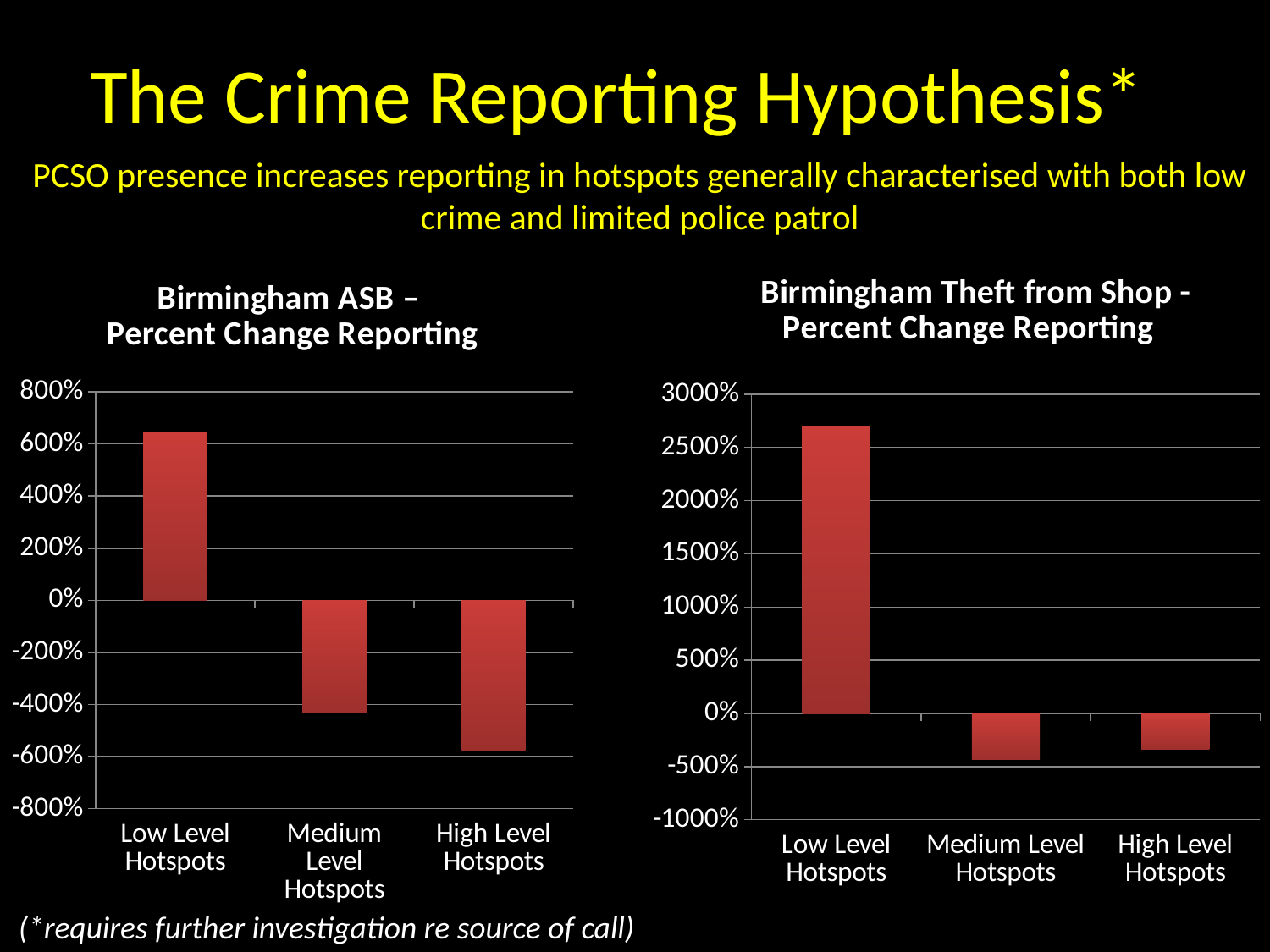
In the Birmingham ASB – Percent Change Reporting chart, is the value for Low Level Hotspots greater or less than 400%? greater In the Birmingham ASB – Percent Change Reporting chart, is the value for High Level Hotspots greater or less than -400%? less In the Birmingham ASB – Percent Change Reporting chart, which category has the lowest value? High Level Hotspots In the Birmingham ASB – Percent Change Reporting chart, how many categories are shown on the x axis? 3 In the Birmingham Theft from Shop - Percent Change Reporting chart, is the value for High Level Hotspots greater or less than -500%? greater In the Birmingham Theft from Shop - Percent Change Reporting chart, which category has the lowest value? Medium Level Hotspots In the Birmingham Theft from Shop - Percent Change Reporting chart, which is larger, the value for Low Level Hotspots or the value for Medium Level Hotspots? Low Level Hotspots What type of chart is the Birmingham ASB – Percent Change Reporting chart? bar chart What is the maximum value shown on the y axis of the Birmingham Theft from Shop - Percent Change Reporting chart? 3000% In the Birmingham ASB – Percent Change Reporting chart, which category has the highest value? Low Level Hotspots In the Birmingham Theft from Shop - Percent Change Reporting chart, which category has the highest value? Low Level Hotspots